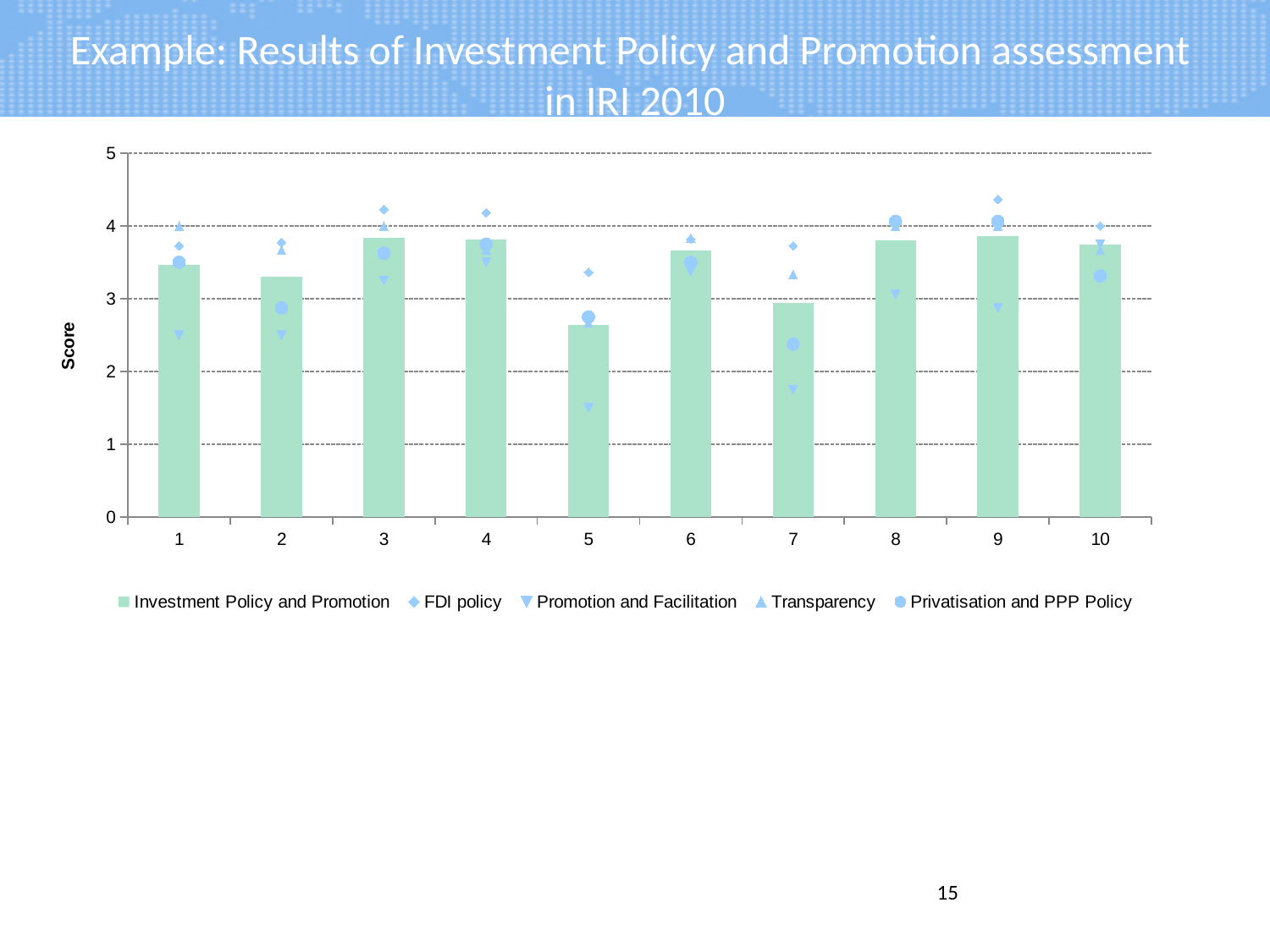
Is the FDI policy value for category 9 greater or less than 4? greater What is the label of the vertical axis? Score How many categories are shown along the x axis? 10 How many series does the legend list? 5 Is the Promotion and Facilitation value for category 5 greater or less than 2? less Is the Privatisation and PPP Policy value for category 7 greater or less than 3? less Which has the larger Investment Policy and Promotion bar, category 1 or category 5? 1 What kind of chart is shown on the slide? bar chart Which has the larger Investment Policy and Promotion bar, category 2 or category 6? 6 Which category has the lowest Investment Policy and Promotion bar? 5